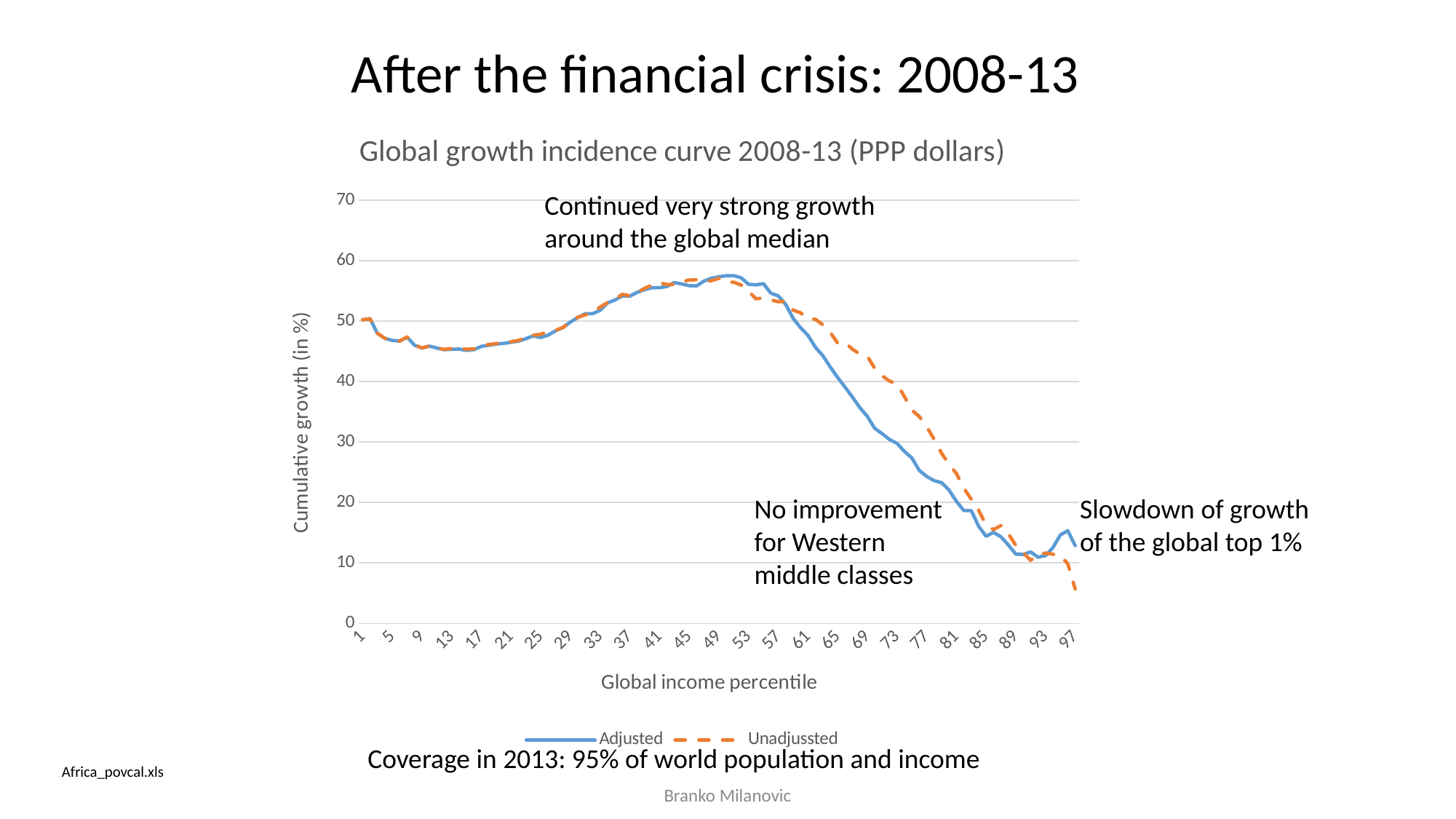
Is the Adjusted value at global income percentile 73 greater or less than 40? less What is the title of the chart? Global growth incidence curve 2008-13 (PPP dollars) Is the Adjusted value at global income percentile 13 greater or less than 50? less Is the Unadjussted value at global income percentile 97 greater or less than 10? less What are the names of the two series in the legend? Adjusted and Unadjussted At global income percentile 97, which series has the higher value, Adjusted or Unadjussted? Adjusted How many series does the chart's legend list? 2 At global income percentile 73, which series has the higher value, Adjusted or Unadjussted? Unadjussted What kind of chart is shown on the slide? Line chart Does the Adjusted line rise or fall between global income percentile 53 and percentile 89? fall